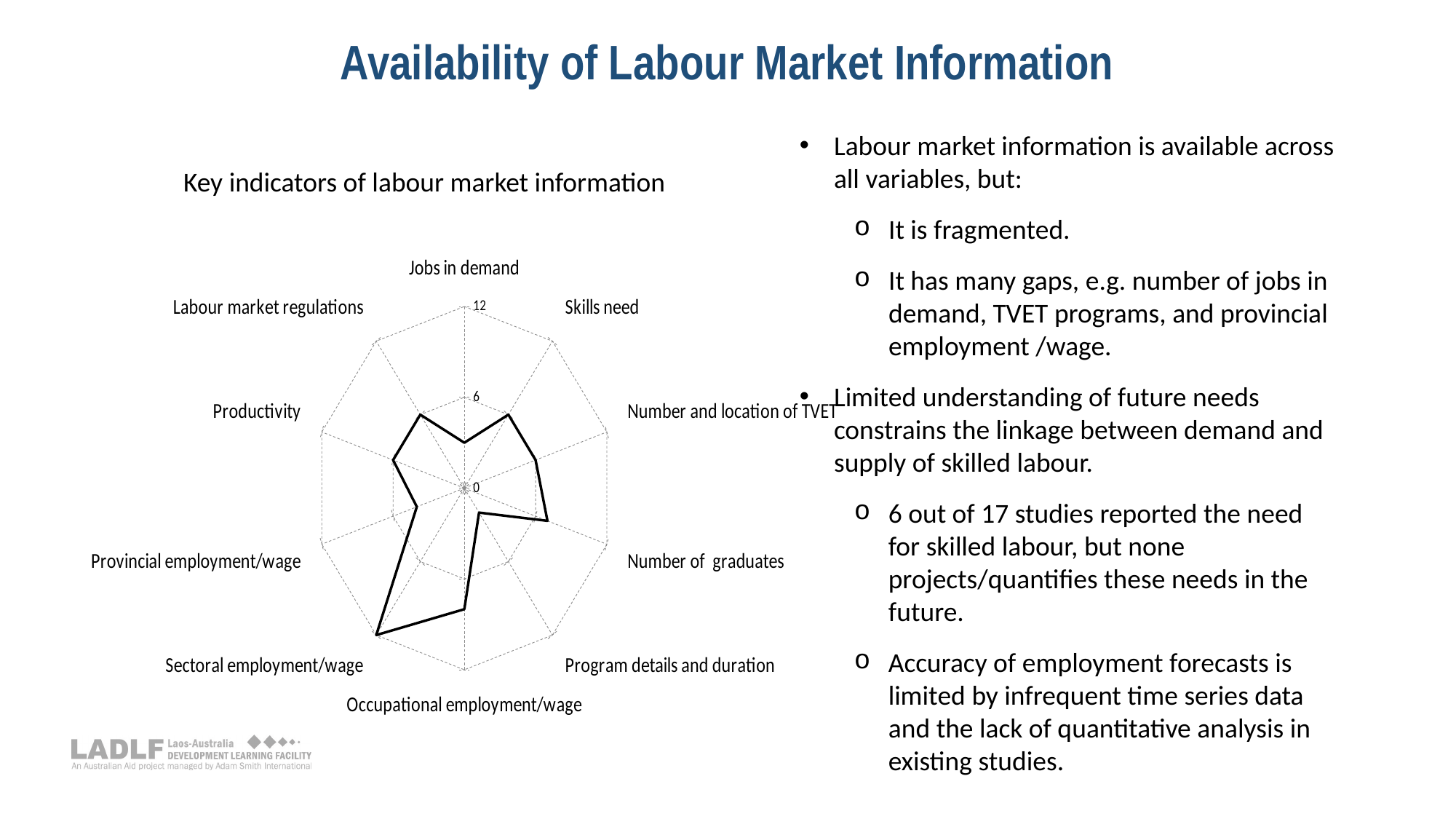
Which indicator has the highest value on the radar chart? Sectoral employment/wage Which has the larger value, Sectoral employment/wage or Jobs in demand? Sectoral employment/wage How many indicator categories are plotted on the radar chart? 10 Is the value for Provincial employment/wage greater or less than 6? less Which has the larger value, Number of graduates or Program details and duration? Number of graduates What is the title of the chart? Key indicators of labour market information Is the value for Sectoral employment/wage greater or less than 6? greater What kind of chart is shown on the slide? Radar chart Which indicator has the lowest value on the radar chart? Program details and duration What is the maximum value shown on the radar chart's axis scale? 12 Is the value for Jobs in demand greater or less than 6? less